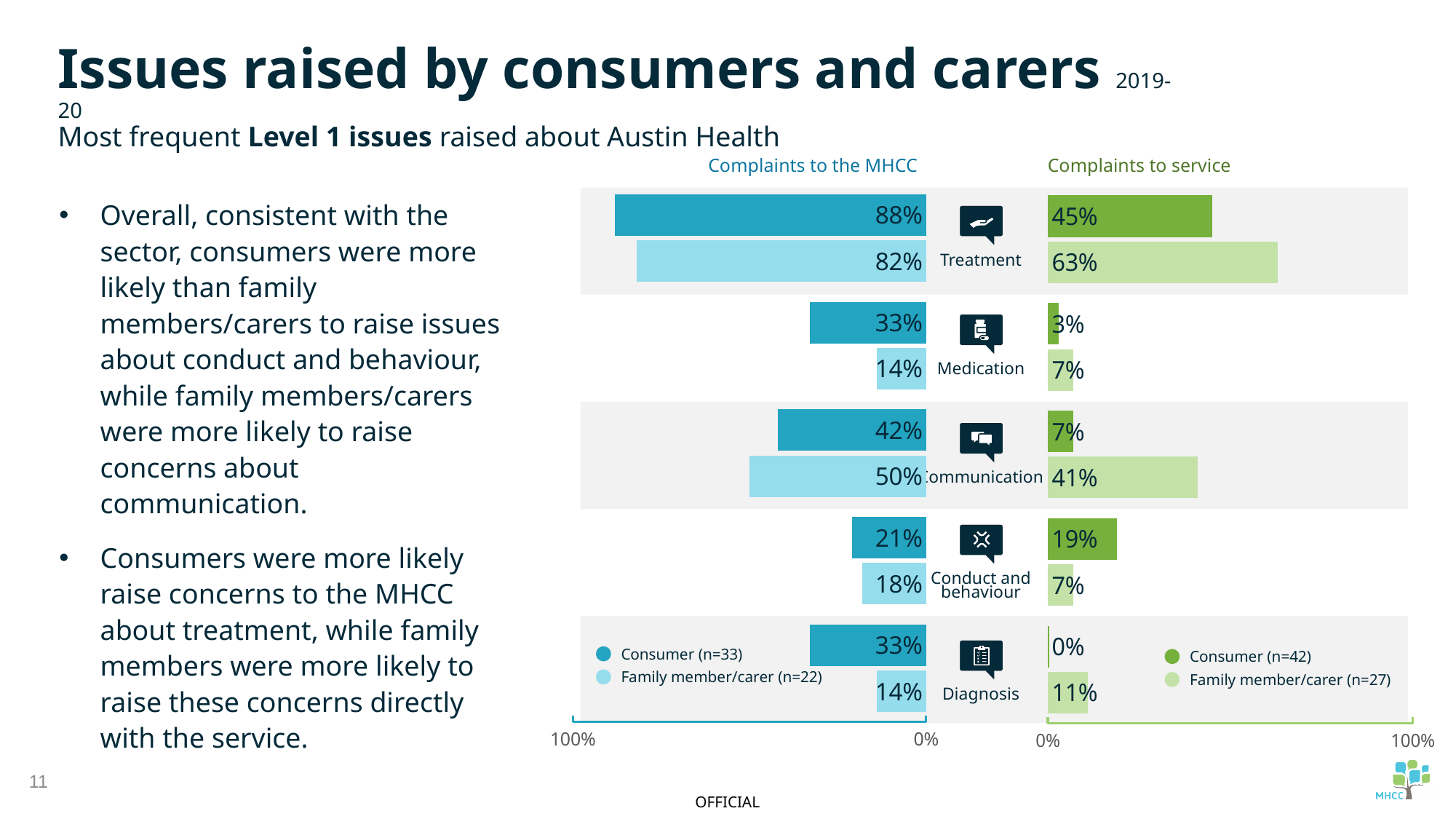
In the 'Complaints to service' chart, which category has the highest Consumer value? Treatment How many issue categories are shown in the 'Complaints to the MHCC' chart? 5 What type of chart is the 'Complaints to the MHCC' chart? Bar chart In the 'Complaints to service' chart, what percentage of family members/carers raised issues about Communication? 41% In the 'Complaints to the MHCC' chart, which is larger for Communication: the Consumer value or the Family member/carer value? Family member/carer In the 'Complaints to the MHCC' chart, what is the difference between the Consumer and Family member/carer values for Medication? 19% How many series does the legend of the 'Complaints to service' chart list? 2 In the 'Complaints to service' chart, which category has the lowest Consumer value? Diagnosis In the 'Complaints to the MHCC' chart, what is the Family member/carer value for Diagnosis? 14% In the 'Complaints to service' chart, what is the difference between the Family member/carer and Consumer values for Treatment? 18% In the 'Complaints to service' chart, is the Consumer value for Conduct and behaviour larger or smaller than the Family member/carer value? larger In the 'Complaints to the MHCC' chart, what percentage of consumers raised issues about Treatment? 88%